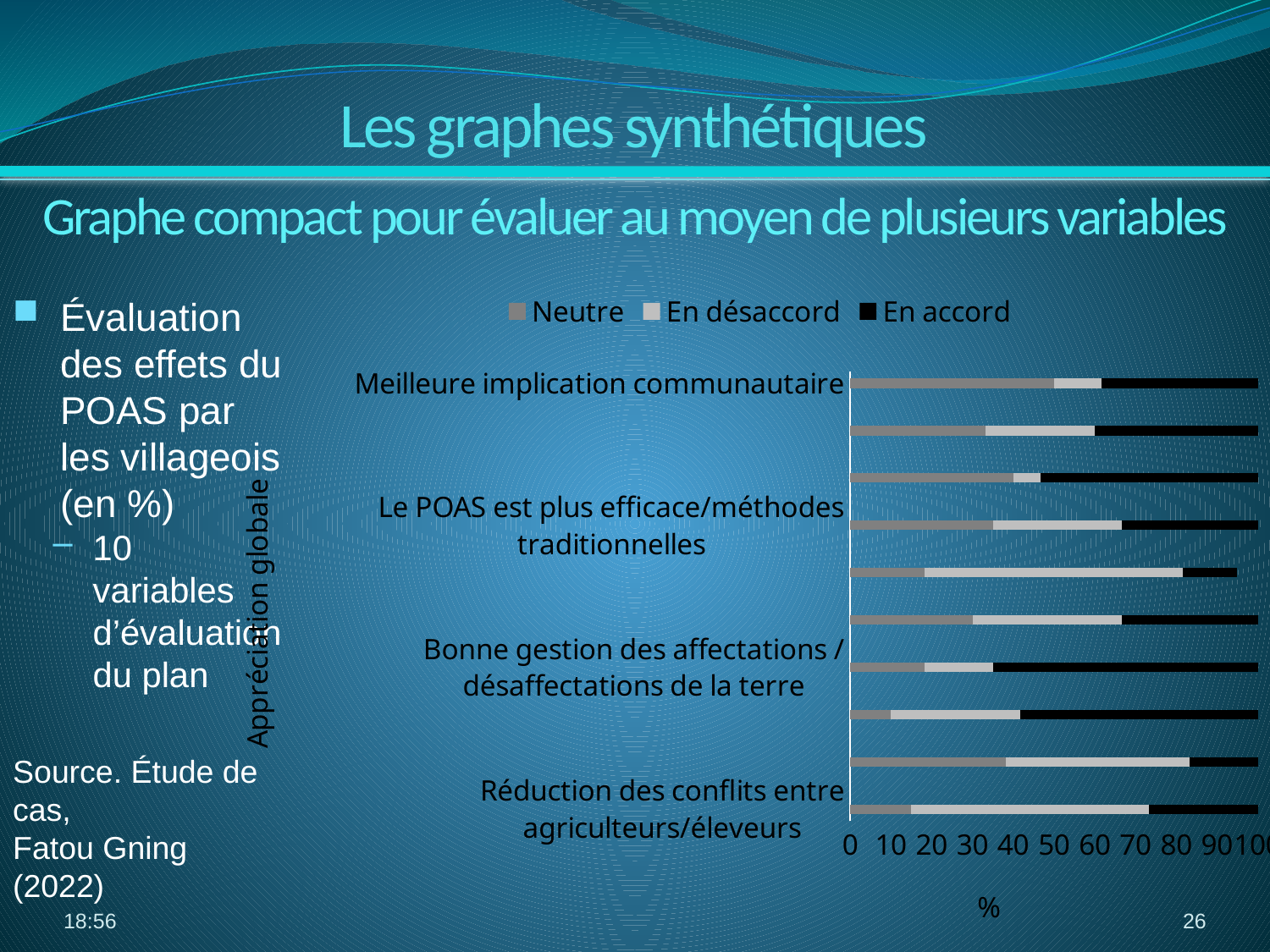
Is the Neutre value for 'Réduction des conflits entre agriculteurs/éleveurs' greater or less than 30? less For 'Meilleure implication communautaire', which is larger: the Neutre segment or the En désaccord segment? Neutre Is the En accord value for 'Bonne gestion des affectations / désaffectations de la terre' greater or less than 50? greater For 'Réduction des conflits entre agriculteurs/éleveurs', which is larger: the Neutre segment or the En désaccord segment? En désaccord How many series does the chart legend list? 3 Is the Neutre value for 'Le POAS est plus efficace/méthodes traditionnelles' greater or less than 20? greater What kind of chart is shown on the slide? Stacked bar chart How many bars are plotted in the chart? 10 What are the three series named in the chart legend? Neutre, En désaccord, En accord What is the title of the horizontal (x) axis of the chart? %